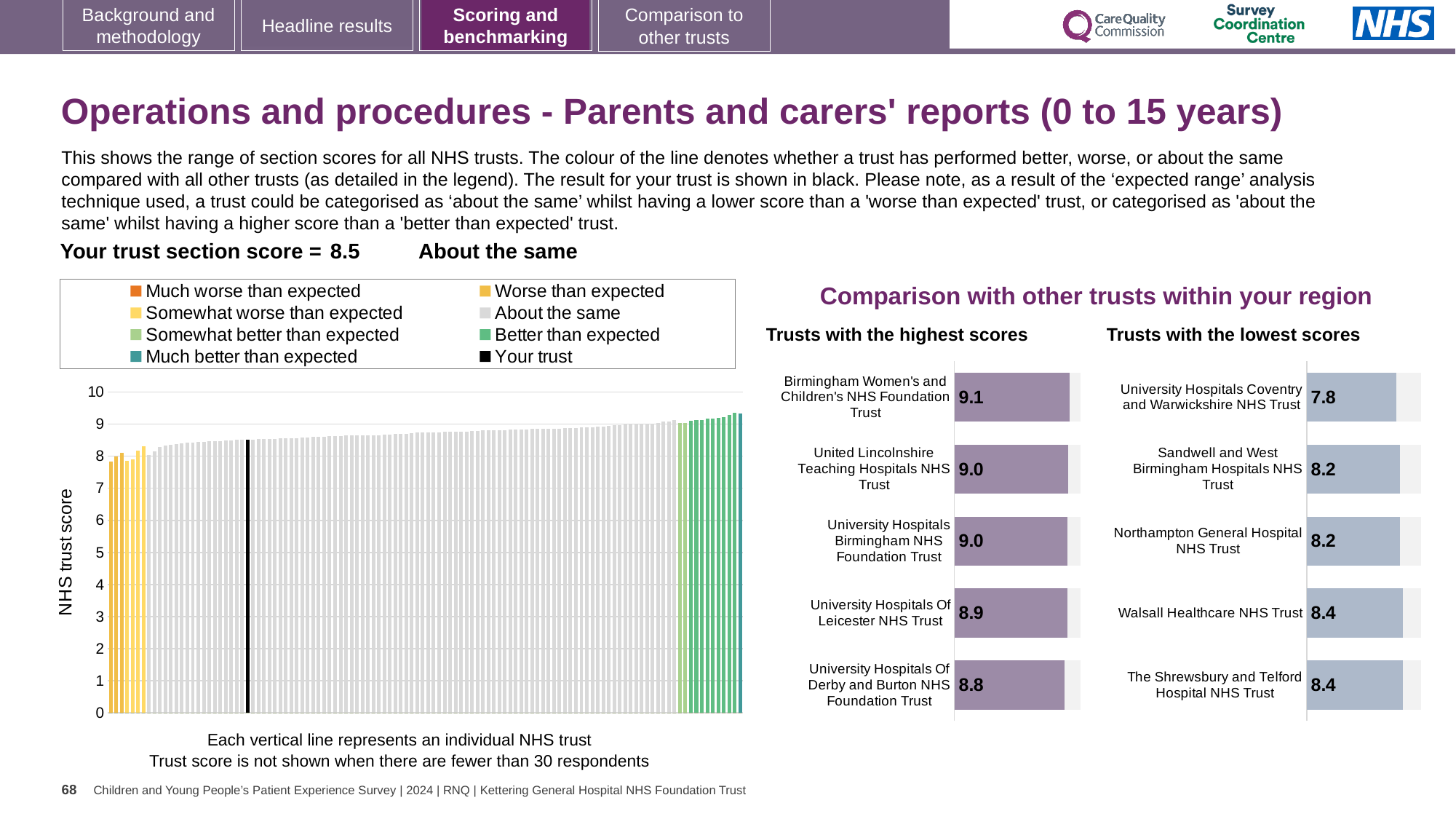
What is the difference between the score for Birmingham Women's and Children's NHS Foundation Trust in the highest scores chart and the score for University Hospitals Coventry and Warwickshire NHS Trust in the lowest scores chart? 1.3 In the 'Trusts with the lowest scores' chart, what is the difference between the scores for Walsall Healthcare NHS Trust and University Hospitals Coventry and Warwickshire NHS Trust? 0.6 In the 'Trusts with the highest scores' chart, what is the score for Birmingham Women's and Children's NHS Foundation Trust? 9.1 How many trusts are shown in the 'Trusts with the lowest scores' chart? 5 In the 'Trusts with the lowest scores' chart, what is the score for University Hospitals Coventry and Warwickshire NHS Trust? 7.8 In the 'Trusts with the lowest scores' chart, which trust has the lowest score? University Hospitals Coventry and Warwickshire NHS Trust In the 'Trusts with the highest scores' chart, which has the larger score: University Hospitals Of Leicester NHS Trust or University Hospitals Of Derby and Burton NHS Foundation Trust? University Hospitals Of Leicester NHS Trust How many entries does the legend of the main 'NHS trust score' chart list? 8 In the main 'NHS trust score' chart, is the value for the black 'Your trust' bar greater or less than 8? greater In the 'Trusts with the highest scores' chart, what is the score for University Hospitals Of Derby and Burton NHS Foundation Trust? 8.8 In the 'Trusts with the highest scores' chart, which trust has the highest score? Birmingham Women's and Children's NHS Foundation Trust In the main 'NHS trust score' chart, do the bar values rise or fall from left to right? rise